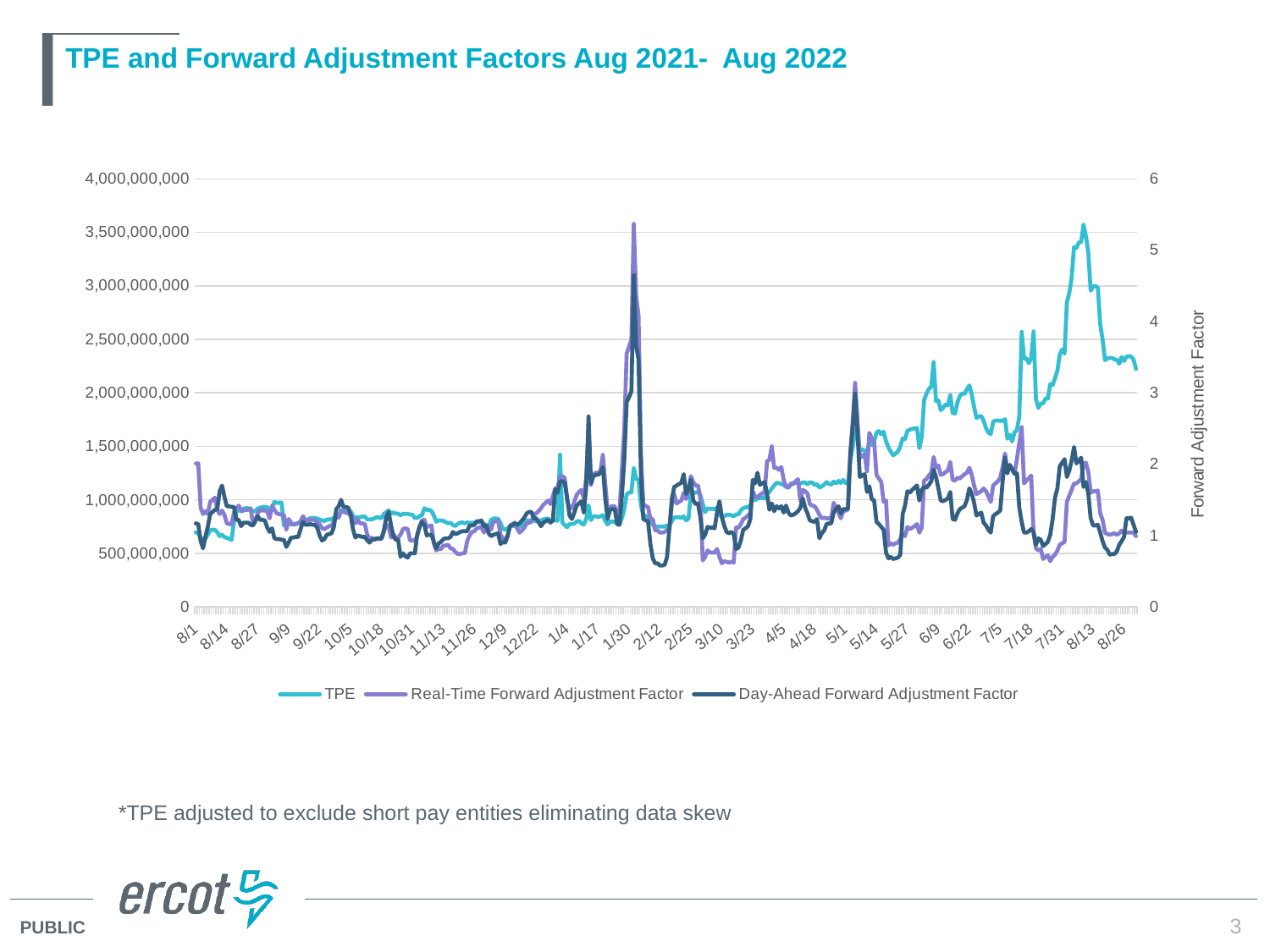
What is the title of the chart? TPE and Forward Adjustment Factors Aug 2021- Aug 2022 Is the Day-Ahead Forward Adjustment Factor around 2/12 greater or less than 1? less Does the TPE series generally rise or fall from August 2021 to August 2022? rise How many series does the legend list? 3 At the spike around 1/30, which is higher: the Real-Time Forward Adjustment Factor or the Day-Ahead Forward Adjustment Factor? Real-Time Forward Adjustment Factor What kind of chart is shown on the slide? Line chart Is the TPE value at the start of the series (8/1) greater or less than 1,000,000,000? less Which series reaches the highest value on the right-hand axis? Real-Time Forward Adjustment Factor Is the peak value of the TPE series around 8/13 greater or less than 3,000,000,000? greater What is the label on the right-hand vertical axis? Forward Adjustment Factor